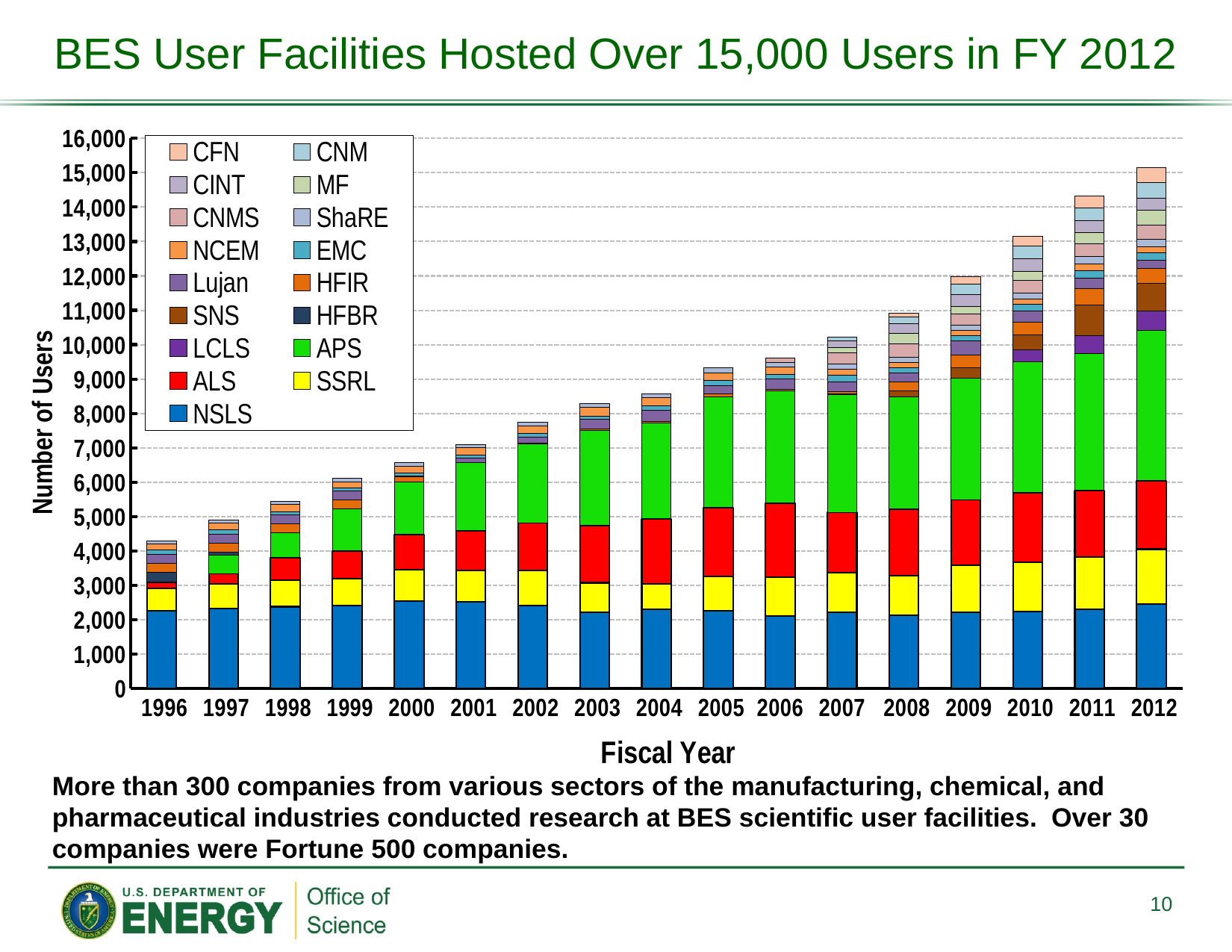
Is the total number of users in 1996 greater or less than 5,000? less Which fiscal year has the shortest stacked bar (the fewest users)? 1996 What is the label of the chart's x axis? Fiscal Year What kind of chart is shown on the slide? Stacked bar chart How many fiscal years are shown along the x axis of the chart? 17 Is the total number of users in 2000 greater or less than 7,000? less Is the total number of users in 2012 greater or less than 14,000? greater How many series does the chart's legend list? 17 What is the label of the chart's y axis? Number of Users Which fiscal year has a taller stacked bar, 2010 or 2011? 2011 Do the total number of users generally rise or fall from 1996 to 2012? Rise Which fiscal year has the tallest stacked bar (the most users)? 2012